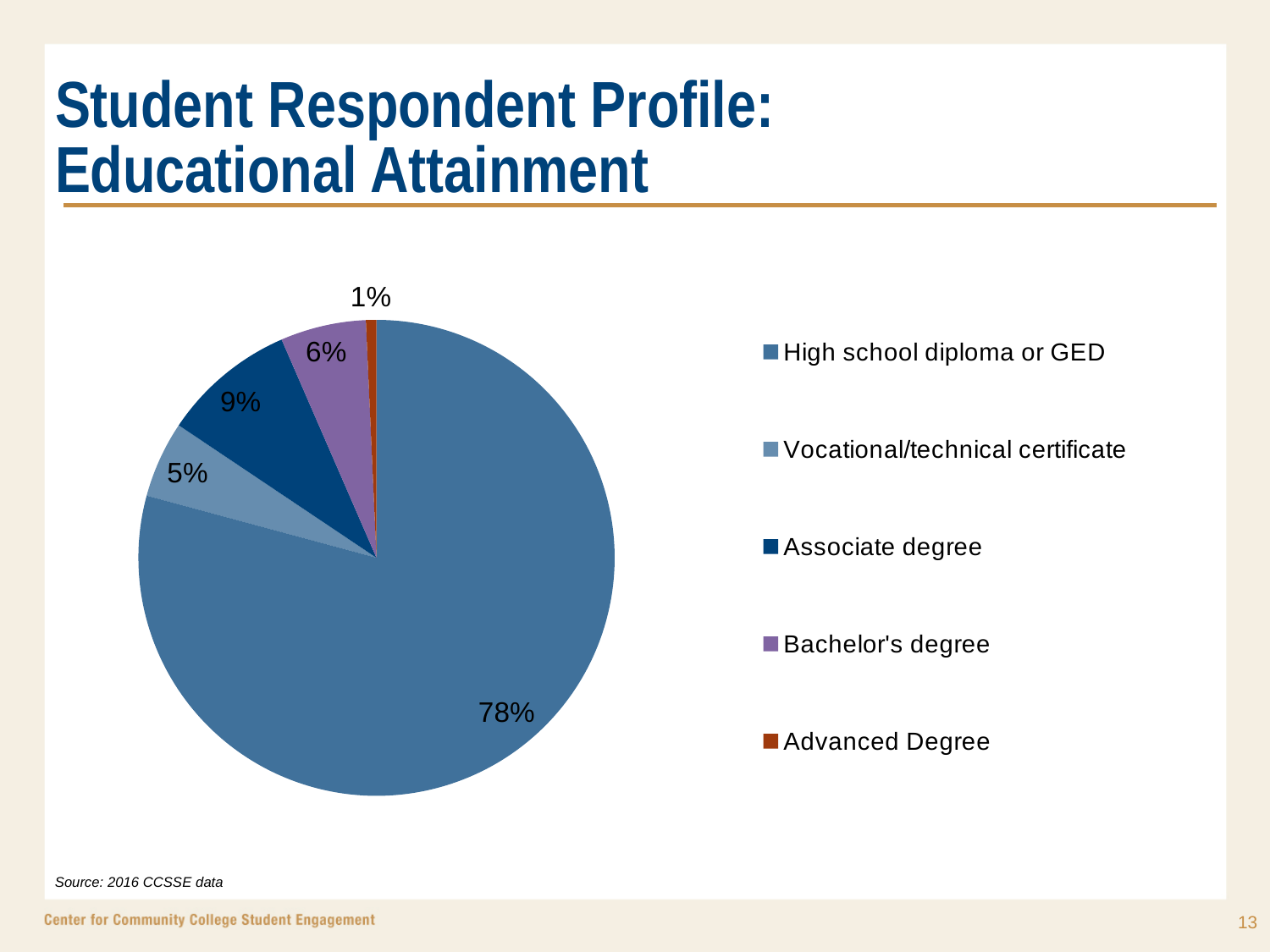
Which is larger: the share with an associate degree or the share with a vocational/technical certificate? Associate degree Which educational attainment category has the smallest share? Advanced Degree What is the source noted at the bottom of the slide? 2016 CCSSE data What share of respondents have an advanced degree? 1% What share of respondents have a vocational/technical certificate? 5% What share of respondents have a high school diploma or GED? 78% Which educational attainment category has the largest share? High school diploma or GED What is the difference in percentage points between the associate degree share and the bachelor's degree share? 3 What kind of chart is shown on the slide? pie chart What share of respondents have an associate degree? 9% What share of respondents have a bachelor's degree? 6% How many categories does the legend list? 5